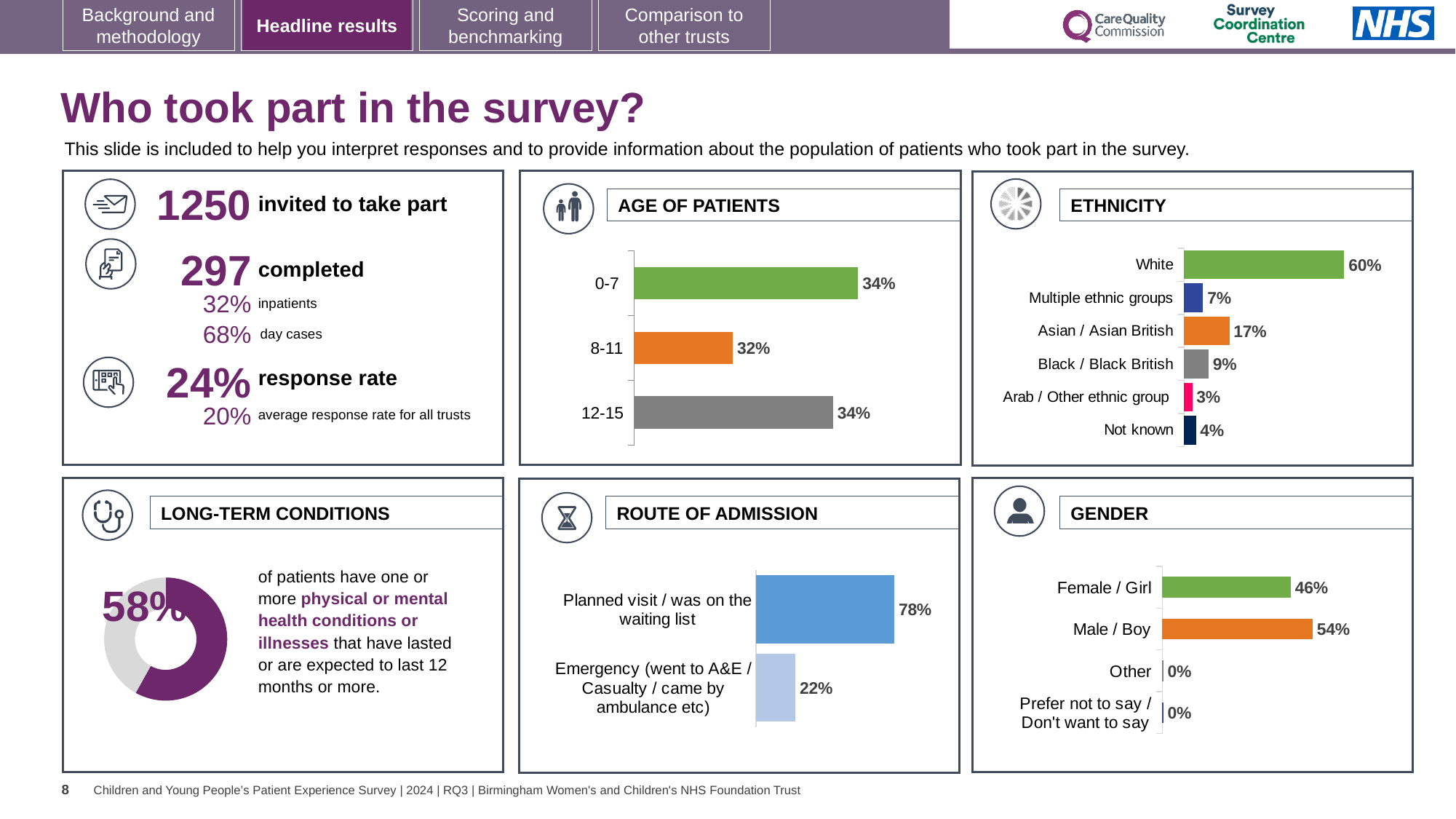
In the ROUTE OF ADMISSION chart, what is the value for Emergency (went to A&E / Casualty / came by ambulance etc)? 22% In the AGE OF PATIENTS chart, what is the value for the 8-11 age group? 32% In the ETHNICITY chart, which category has the highest value? White In the ETHNICITY chart, what is the value for Asian / Asian British? 17% In the AGE OF PATIENTS chart, how many age categories are shown? 3 In the ROUTE OF ADMISSION chart, what is the difference between the Planned visit and Emergency values? 56% In the ETHNICITY chart, which category has the lowest value? Arab / Other ethnic group In the GENDER chart, what is the value for Female / Girl? 46% In the GENDER chart, which is larger, Female / Girl or Male / Boy? Male / Boy In the LONG-TERM CONDITIONS chart, what share of patients have one or more long-term conditions? 58% In the ETHNICITY chart, what is the difference between the values for Black / Black British and Arab / Other ethnic group? 6% What kind of chart is used in the LONG-TERM CONDITIONS panel? Donut chart